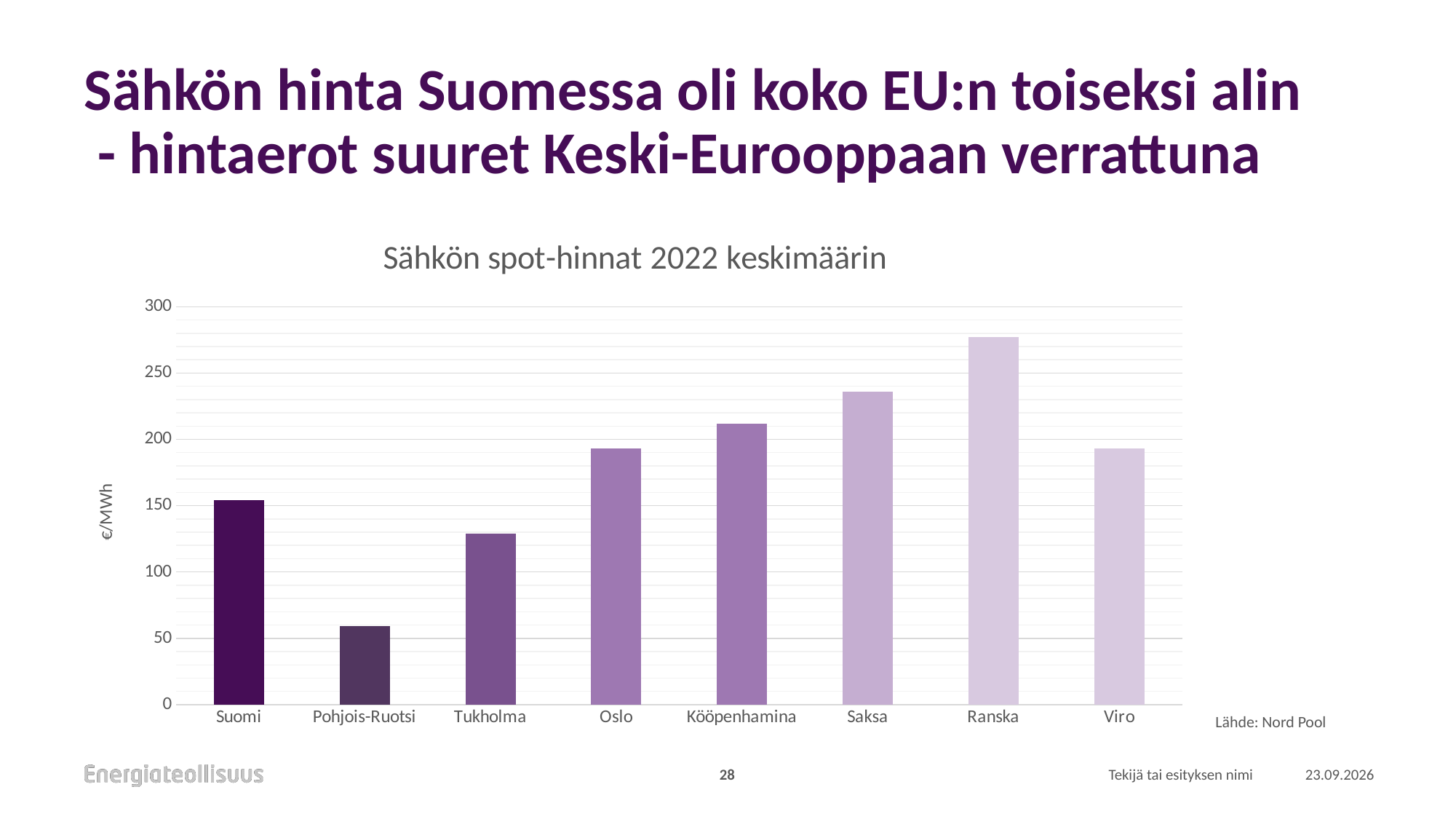
What type of chart is shown on the slide? Bar chart Which category has the lowest value in the chart? Pohjois-Ruotsi What is the title of the chart? Sähkön spot-hinnat 2022 keskimäärin Is the value for Kööpenhamina greater or less than 200? greater Which is larger, the value for Tukholma or the value for Oslo? Oslo Which category has the highest value in the chart? Ranska Is the value for Ranska greater or less than 250? greater What unit is shown on the vertical axis of the chart? €/MWh How many categories are shown on the x axis of the chart? 8 Which is larger, the value for Saksa or the value for Suomi? Saksa Is the value for Pohjois-Ruotsi greater or less than 100? less